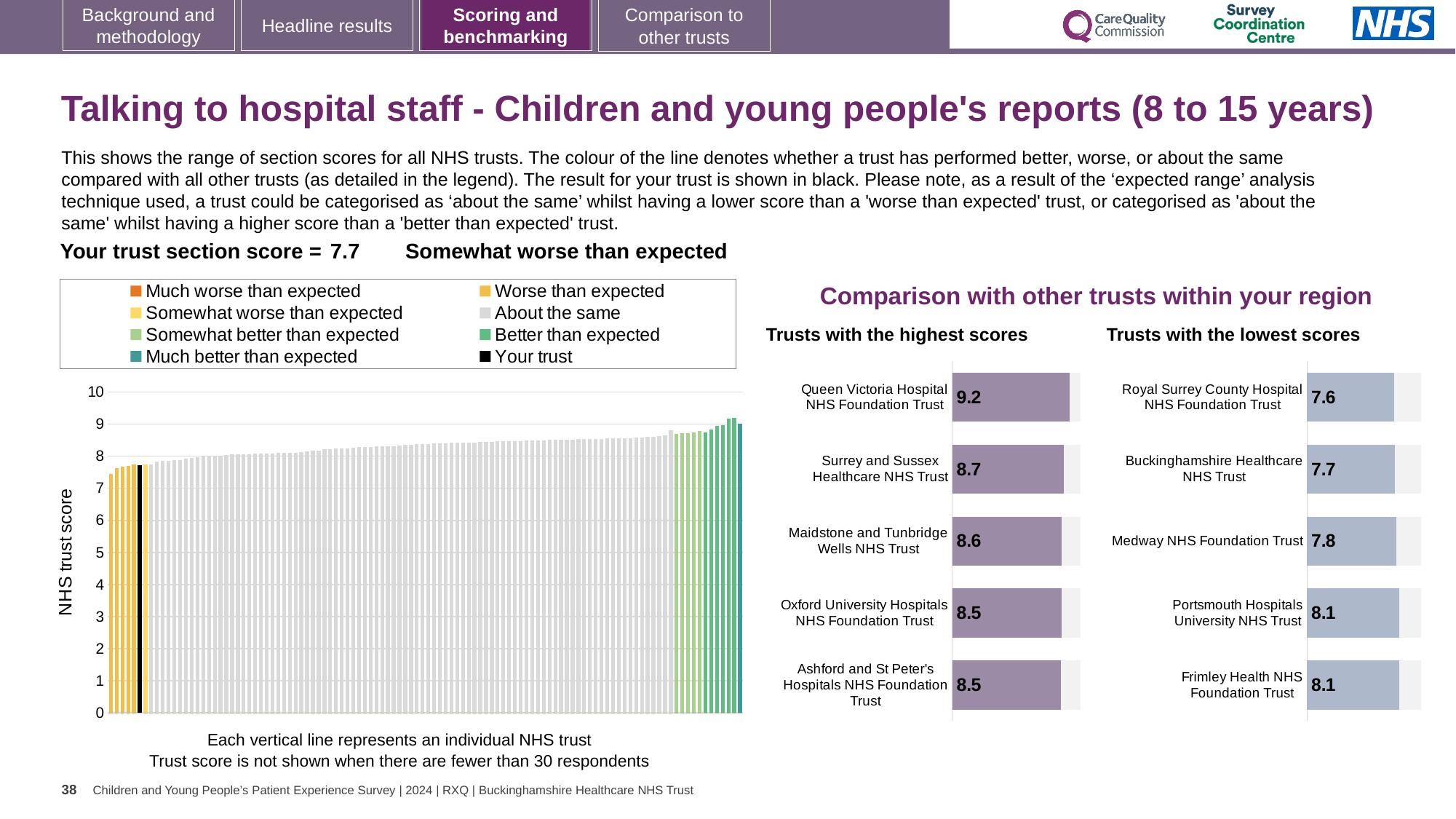
In the 'Trusts with the lowest scores' chart, which trust has the lowest score? Royal Surrey County Hospital NHS Foundation Trust In the large chart on the left showing all NHS trusts, what is the section score for your trust (the black bar)? 7.7 In the 'Trusts with the highest scores' chart, what is the difference between the scores of Queen Victoria Hospital NHS Foundation Trust and Surrey and Sussex Healthcare NHS Trust? 0.5 In the 'Trusts with the lowest scores' chart, which has the larger score: Medway NHS Foundation Trust or Buckinghamshire Healthcare NHS Trust? Medway NHS Foundation Trust In the large chart on the left showing all NHS trusts, is the value of the leftmost bar greater or less than 8? less In the 'Trusts with the lowest scores' chart, what is the score for Medway NHS Foundation Trust? 7.8 In the 'Trusts with the highest scores' chart, which trust has the highest score? Queen Victoria Hospital NHS Foundation Trust How many entries does the legend above the large chart on the left list? 8 In the 'Trusts with the highest scores' chart, what is the score for Maidstone and Tunbridge Wells NHS Trust? 8.6 In the 'Trusts with the highest scores' chart, what is the score for Queen Victoria Hospital NHS Foundation Trust? 9.2 In the large chart on the left showing all NHS trusts, do the bar values rise or fall from left to right? rise How many trusts are shown in the 'Trusts with the lowest scores' chart? 5